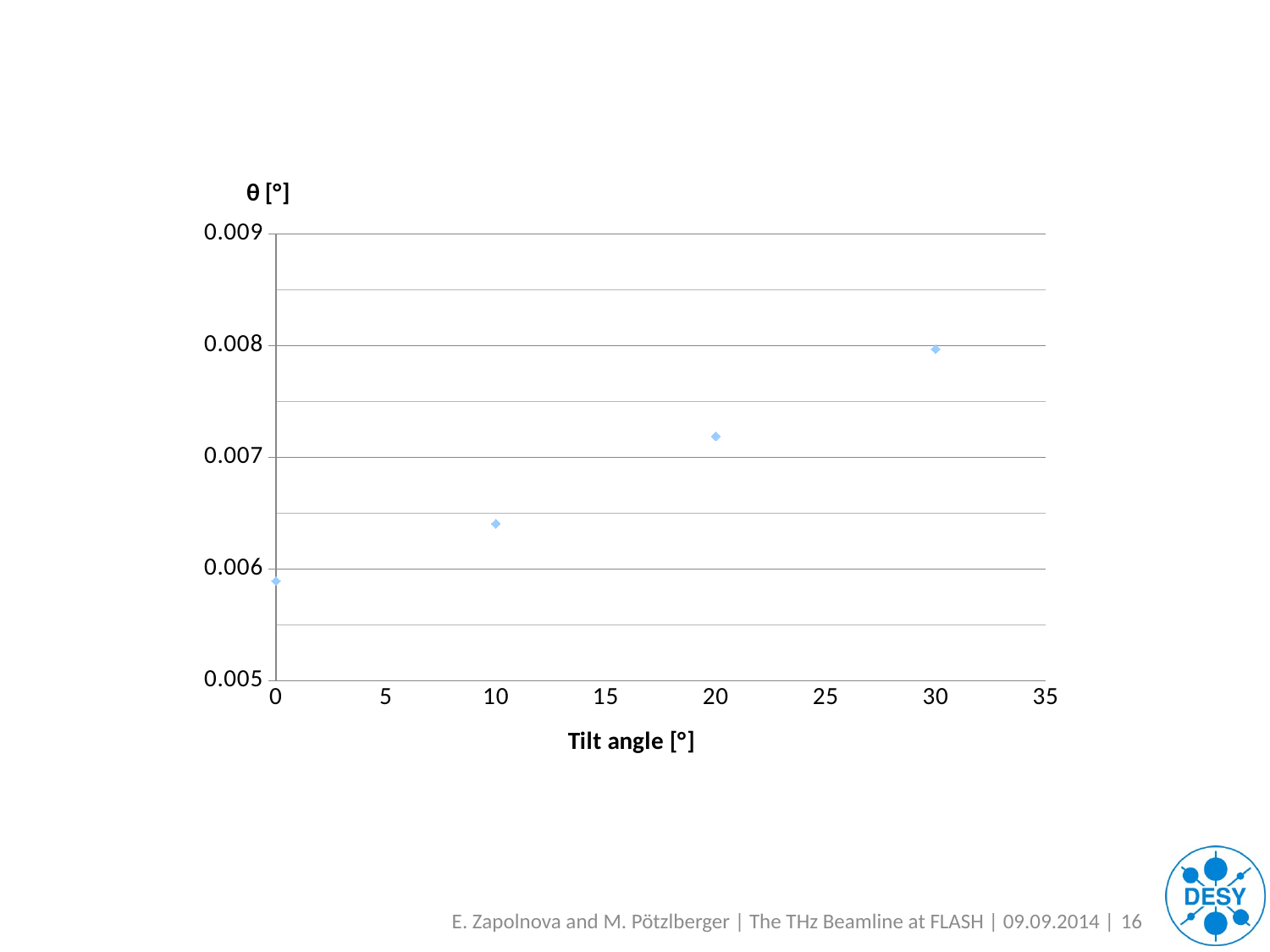
At which tilt angle is the plotted value highest? 30 Do the plotted values rise or fall as the tilt angle increases? rise Which has the larger value: tilt angle 10 or tilt angle 20? tilt angle 20 Is the value at tilt angle 10 greater or less than 0.006? greater At which tilt angle is the plotted value lowest? 0 How many data points are plotted on the chart? 4 What is the label of the vertical axis? θ [°] What kind of chart is shown on the slide? scatter chart Is the value at tilt angle 10 greater or less than 0.007? less Is the value at tilt angle 30 greater or less than 0.007? greater What is the label of the horizontal axis? Tilt angle [°]